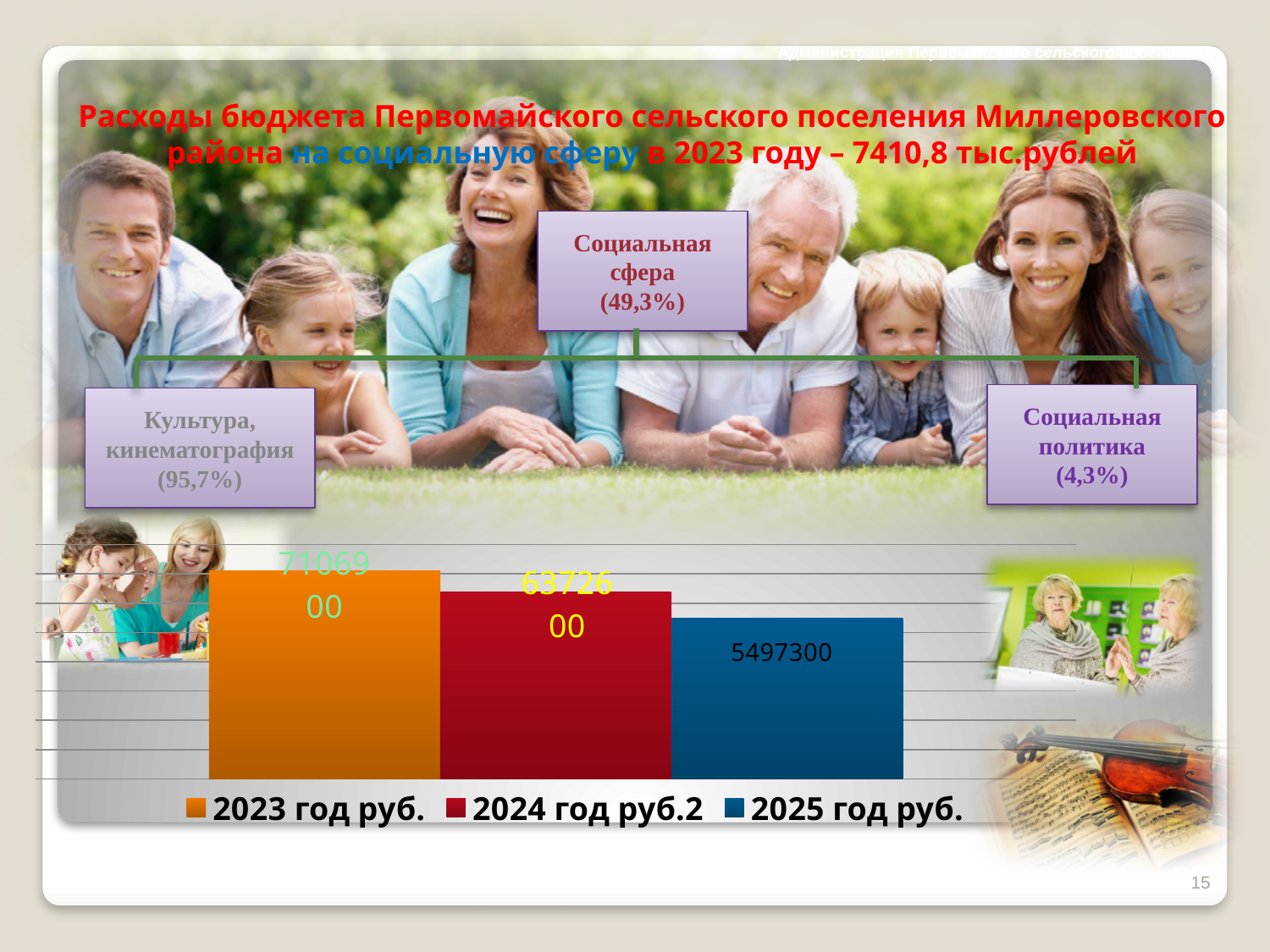
How many bars are plotted in the chart? 3 Which is larger, the 2024 год руб.2 value or the 2025 год руб. value? 2024 год руб.2 What kind of chart is shown on the slide? bar chart What is the difference between the 2023 год руб. value and the 2024 год руб.2 value? 734300 Do the values rise or fall from the 2023 bar to the 2025 bar? fall What is the value shown for the 2025 год руб. bar? 5497300 What is the difference between the 2023 год руб. value and the 2025 год руб. value? 1609600 How many series does the legend list? 3 Which series has the highest value in the chart? 2023 год руб. What is the value shown for the 2024 год руб.2 bar? 6372600 Which series has the lowest value in the chart? 2025 год руб. What is the value shown for the 2023 год руб. bar? 7106900